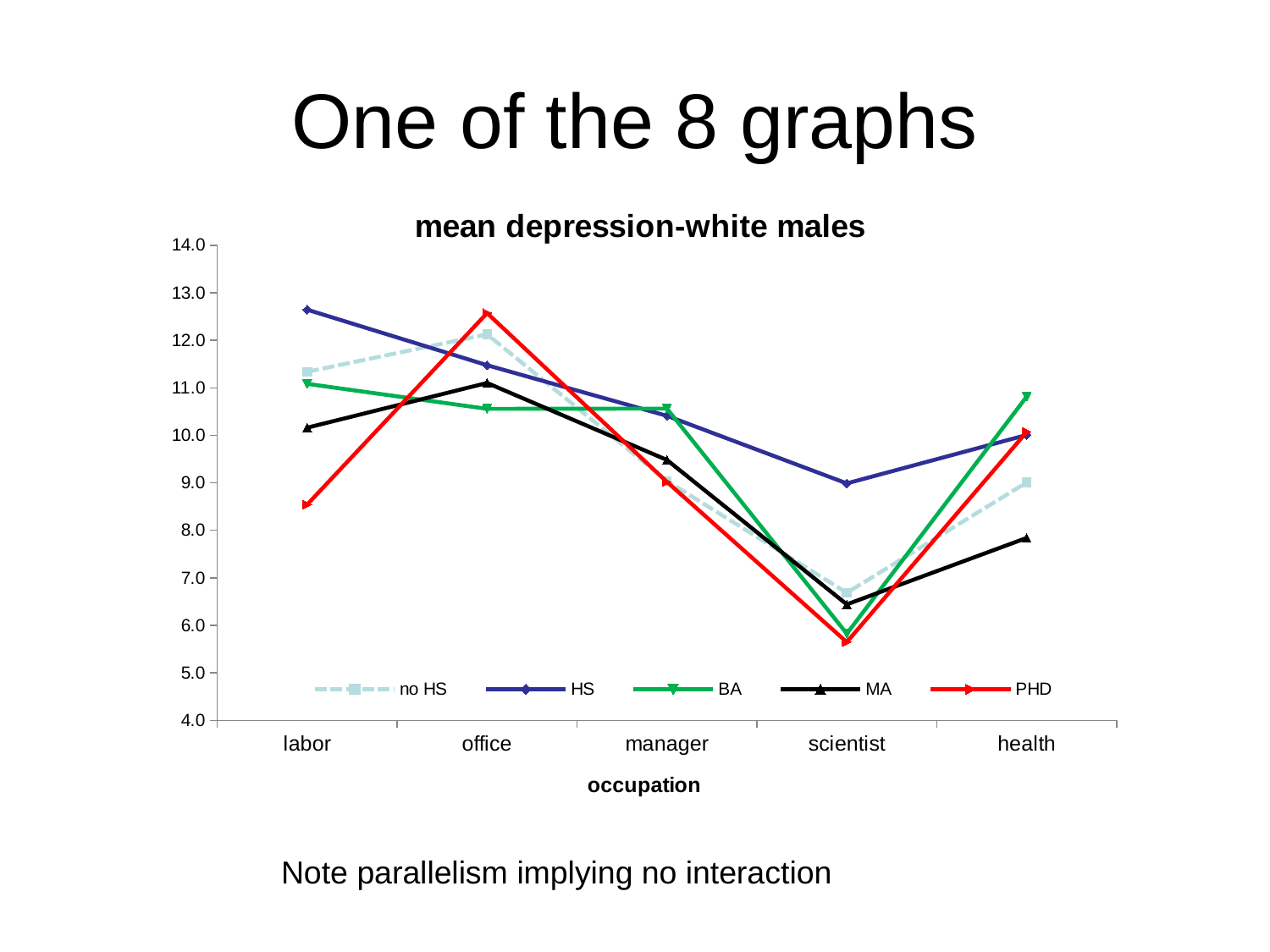
Is the value for HS at labor greater or less than 12.0? greater For the PHD series, which occupation has the lowest value? scientist What kind of chart is shown on the slide? line chart Is the value for PHD at labor greater or less than 9.0? less At scientist, which is larger: HS or BA? HS Is the value for MA at health greater or less than 8.0? less How many occupation categories are shown on the x axis? 5 Which series has the lowest value at labor? PHD Does the MA series rise or fall from manager to scientist? fall For the PHD series, which occupation has the highest value? office How many series does the legend list? 5 What is the title of the chart? mean depression-white males